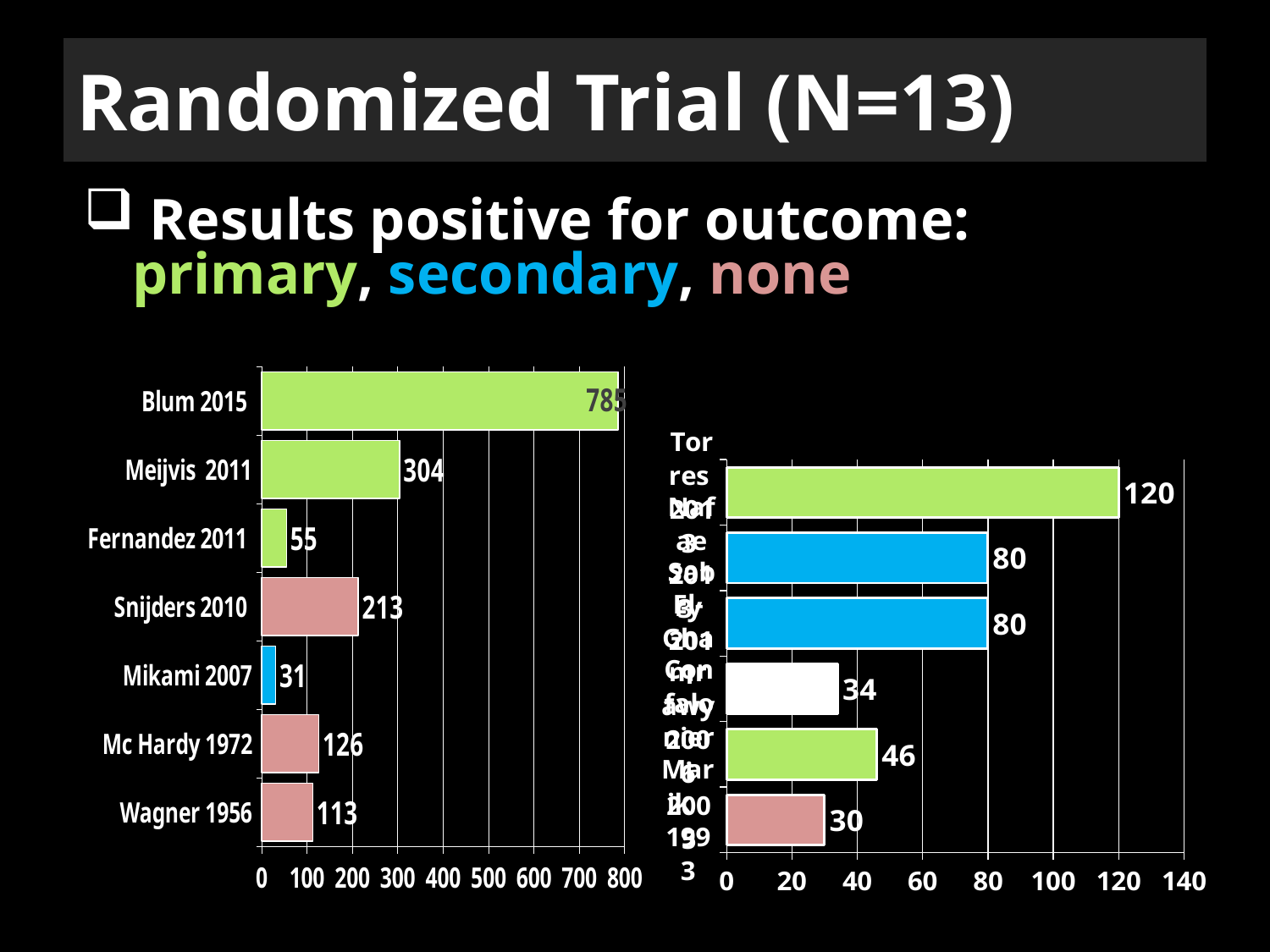
In the right chart, what is the highest value shown on a data label? 120 How many trials are shown in the left chart? 7 In the left chart, what is the value for Wagner 1956? 113 In the left chart, which is larger, the value for Mc Hardy 1972 or the value for Wagner 1956? Mc Hardy 1972 In the left chart, which trial has the highest value? Blum 2015 In the left chart, what is the difference between the values for Meijvis 2011 and Fernandez 2011? 249 What kind of chart is the left chart? bar chart In the left chart, what is the value for Snijders 2010? 213 In the left chart, which trial has the lowest value? Mikami 2007 In the left chart, is the value for Snijders 2010 greater or less than 200? greater How many bars are shown in the right chart? 6 In the left chart, what is the value for Blum 2015? 785